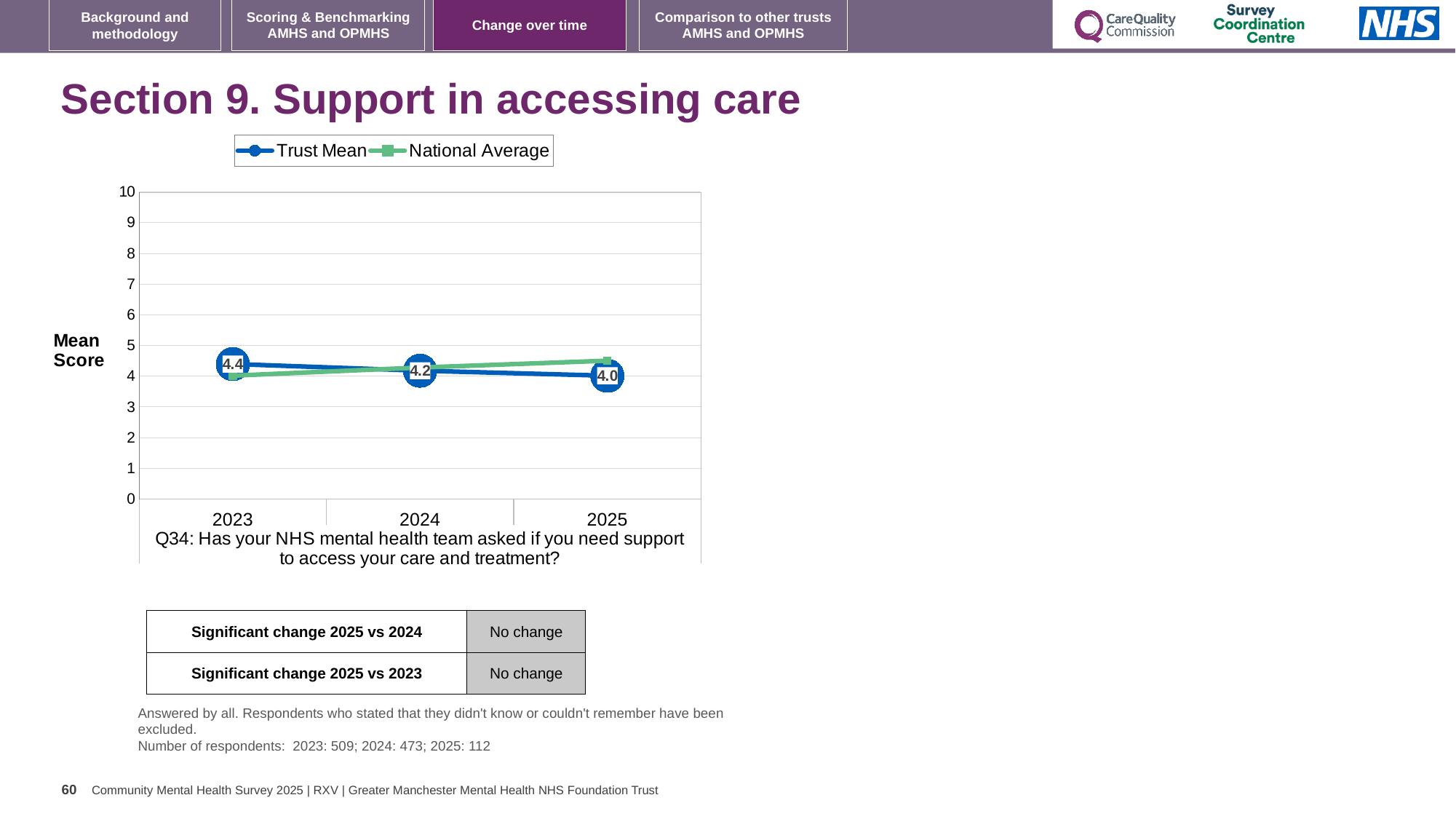
In which year is the Trust Mean lowest? 2025 What is the difference between the Trust Mean in 2023 and in 2025? 0.4 In which year is the Trust Mean highest? 2023 Which is larger, the Trust Mean for 2023 or for 2025? 2023 How many years are plotted on the x axis? 3 Is the National Average value for 2025 greater or less than 4? greater How many series does the legend list? 2 What is the Trust Mean value for 2024? 4.2 What is the Trust Mean value for 2023? 4.4 What kind of chart is shown on the slide? Line chart Does the Trust Mean rise or fall from 2023 to 2025? Fall What is the Trust Mean value for 2025? 4.0